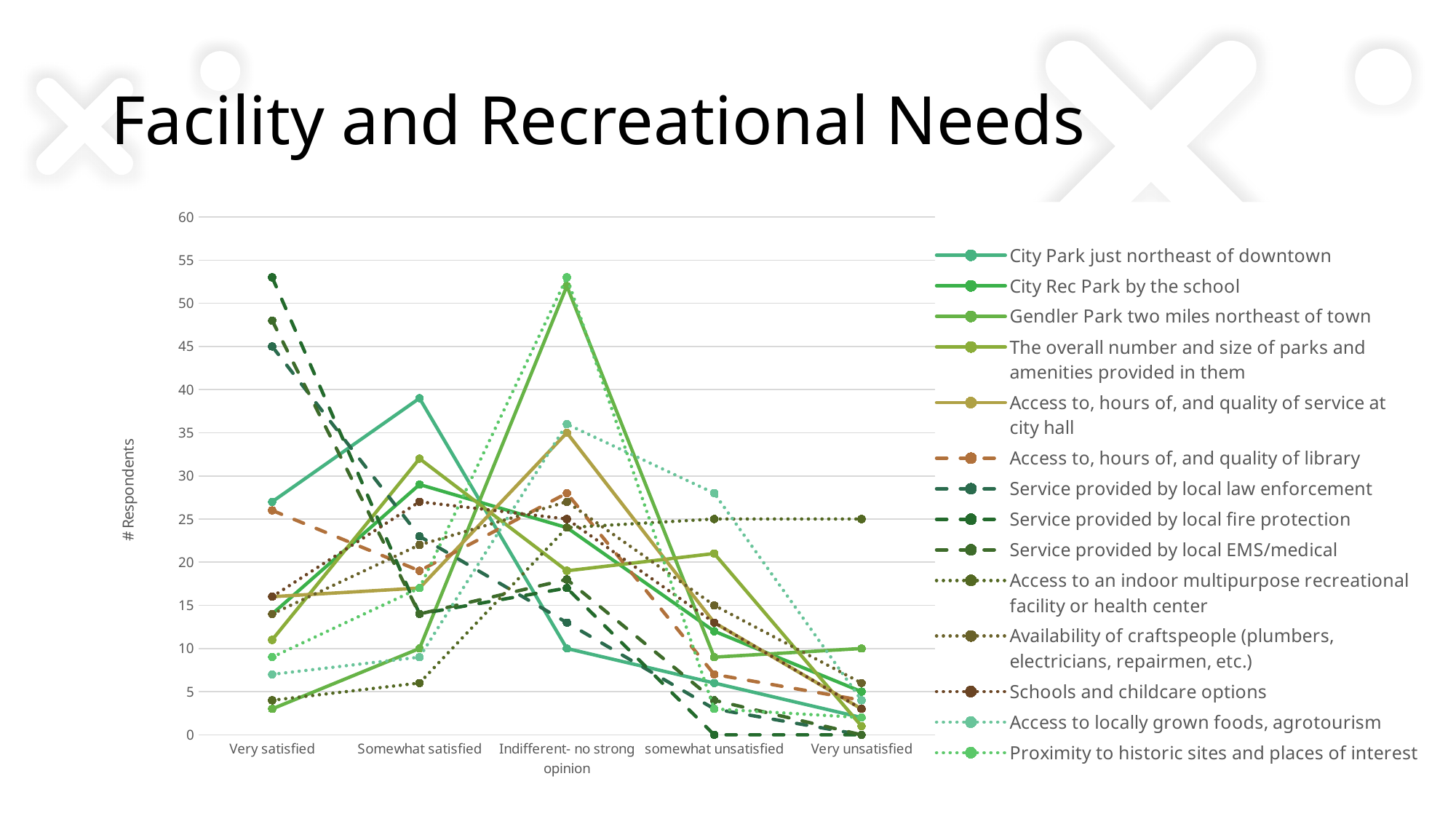
Is the value for 'Availability of craftspeople (plumbers, electricians, repairmen, etc.)' at 'Very satisfied' greater or less than 5? greater What kind of chart is shown on the slide? Line chart What is the label of the vertical axis? # Respondents Is the value for 'City Park just northeast of downtown' at 'Somewhat satisfied' greater or less than 35? greater How many series does the legend list? 14 For 'Gendler Park two miles northeast of town', which category has the highest value? Indifferent- no strong opinion Is the value for 'Access to, hours of, and quality of library' at 'Very satisfied' greater or less than 20? greater How many categories are shown along the x axis? 5 Does the value for 'City Park just northeast of downtown' rise or fall from 'Somewhat satisfied' to 'Very unsatisfied'? fall Which series has the highest value at 'Very satisfied'? Service provided by local fire protection